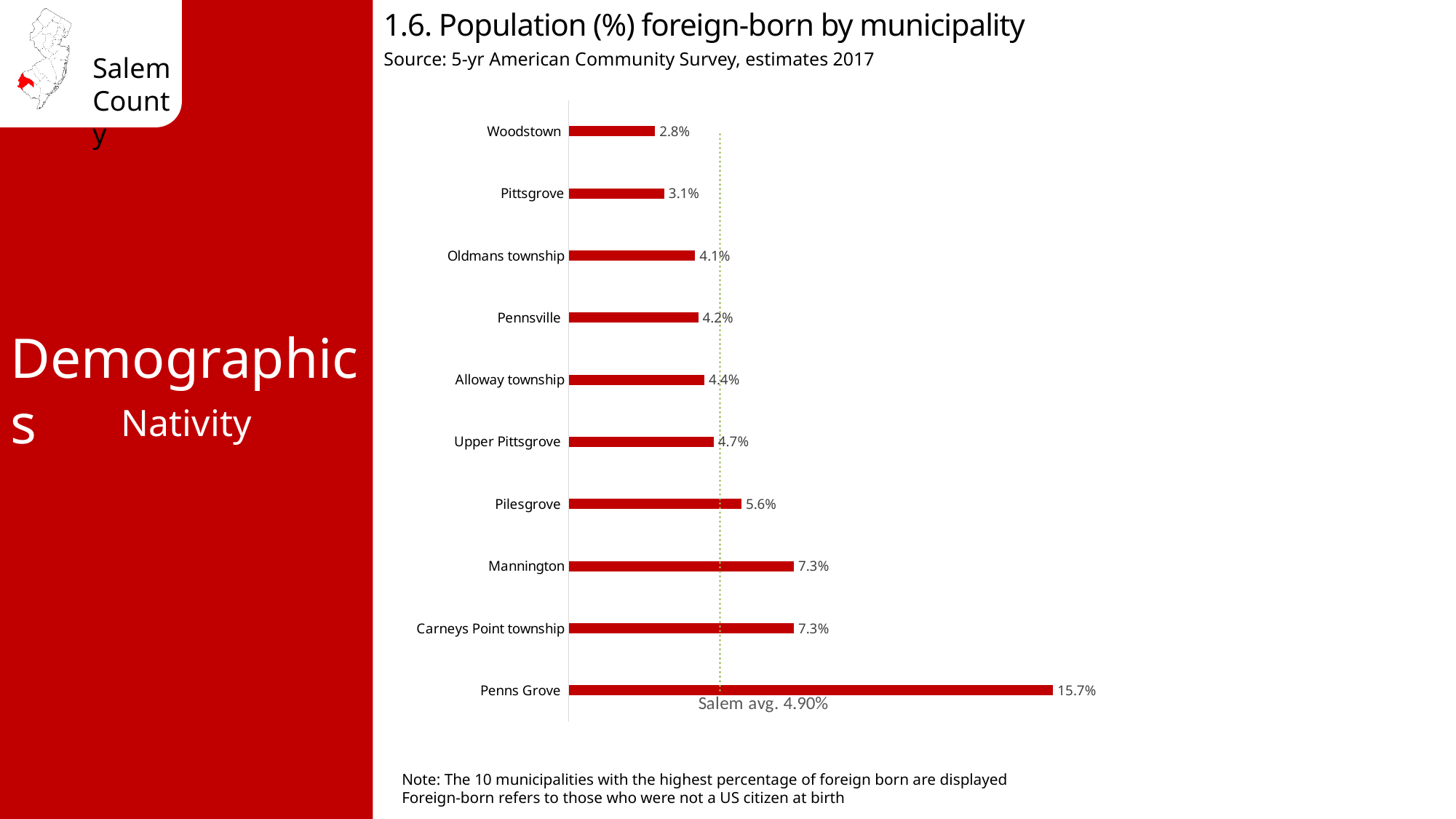
What is the foreign-born population percentage for Pilesgrove? 5.6% Which municipality has the highest percentage of foreign-born population? Penns Grove What kind of chart is shown on the slide? Bar chart What is the Salem average foreign-born percentage marked by the dotted line? 4.90% What is the foreign-born population percentage for Woodstown? 2.8% What is the foreign-born population percentage for Penns Grove? 15.7% Which municipality has the lowest percentage of foreign-born population? Woodstown What is the source of the data shown in the chart? 5-yr American Community Survey, estimates 2017 Which has a higher foreign-born percentage, Upper Pittsgrove or Oldmans township? Upper Pittsgrove What is the difference between the foreign-born percentages of Pilesgrove and Pittsgrove? 2.5% How many municipalities are shown in the chart? 10 What is the difference between the foreign-born percentages of Penns Grove and Mannington? 8.4%